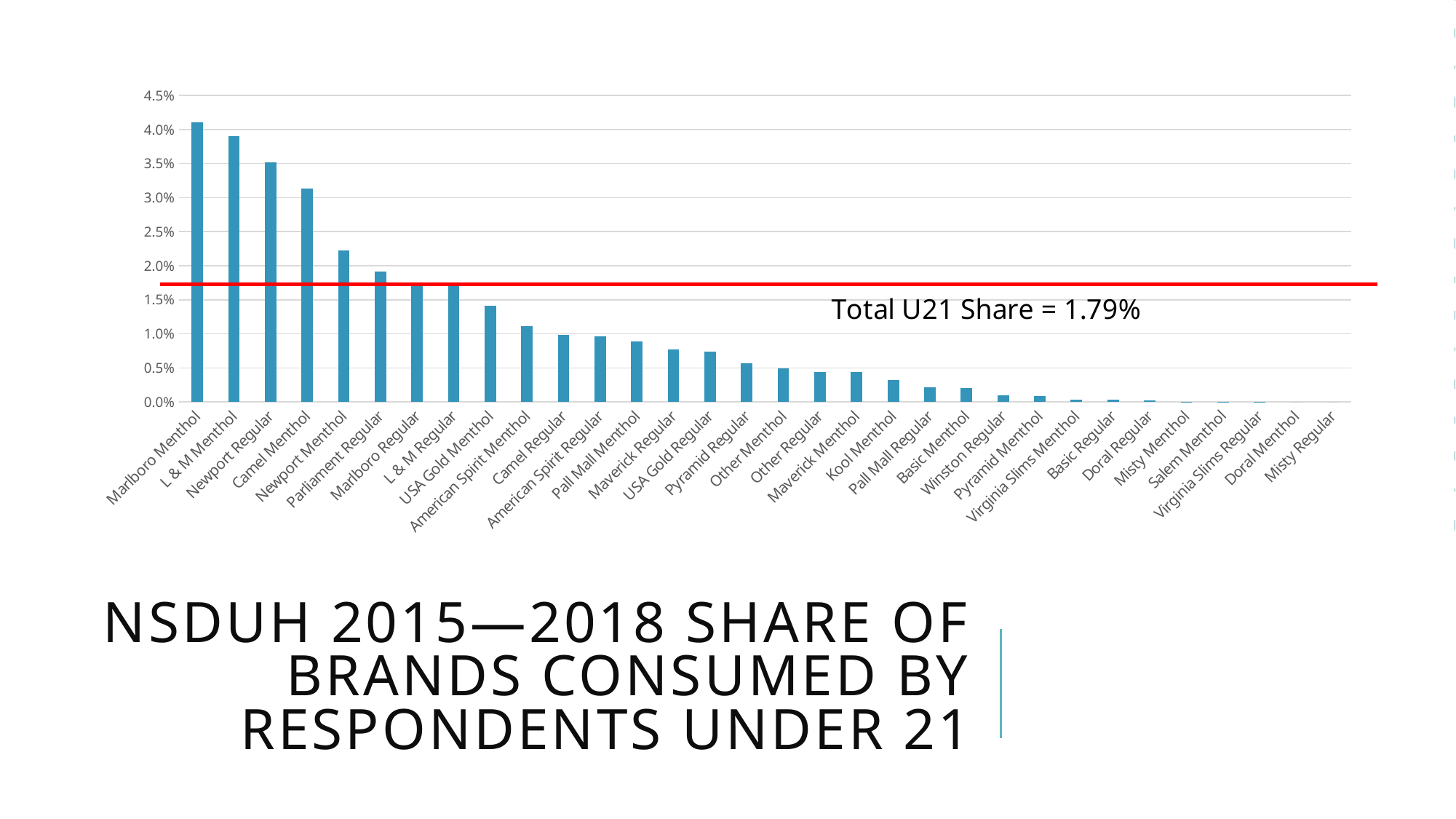
What value does the red horizontal line represent, according to the annotation? Total U21 Share = 1.79% Is the value for Newport Menthol greater or less than 2.0%? greater What kind of chart is shown on the slide? bar chart Which is larger, the share for Marlboro Menthol or for L & M Menthol? Marlboro Menthol What is the title of the slide containing the chart? NSDUH 2015—2018 Share of Brands Consumed by Respondents Under 21 Is the value for Kool Menthol greater or less than 0.5%? less Is the value for Newport Regular greater or less than 3.0%? greater Which brand has the highest share of respondents under 21? Marlboro Menthol Which is larger, the share for Newport Regular or for Camel Menthol? Newport Regular How many brands are plotted along the x axis? 32 Do the bar values rise or fall from left to right along the x axis? fall